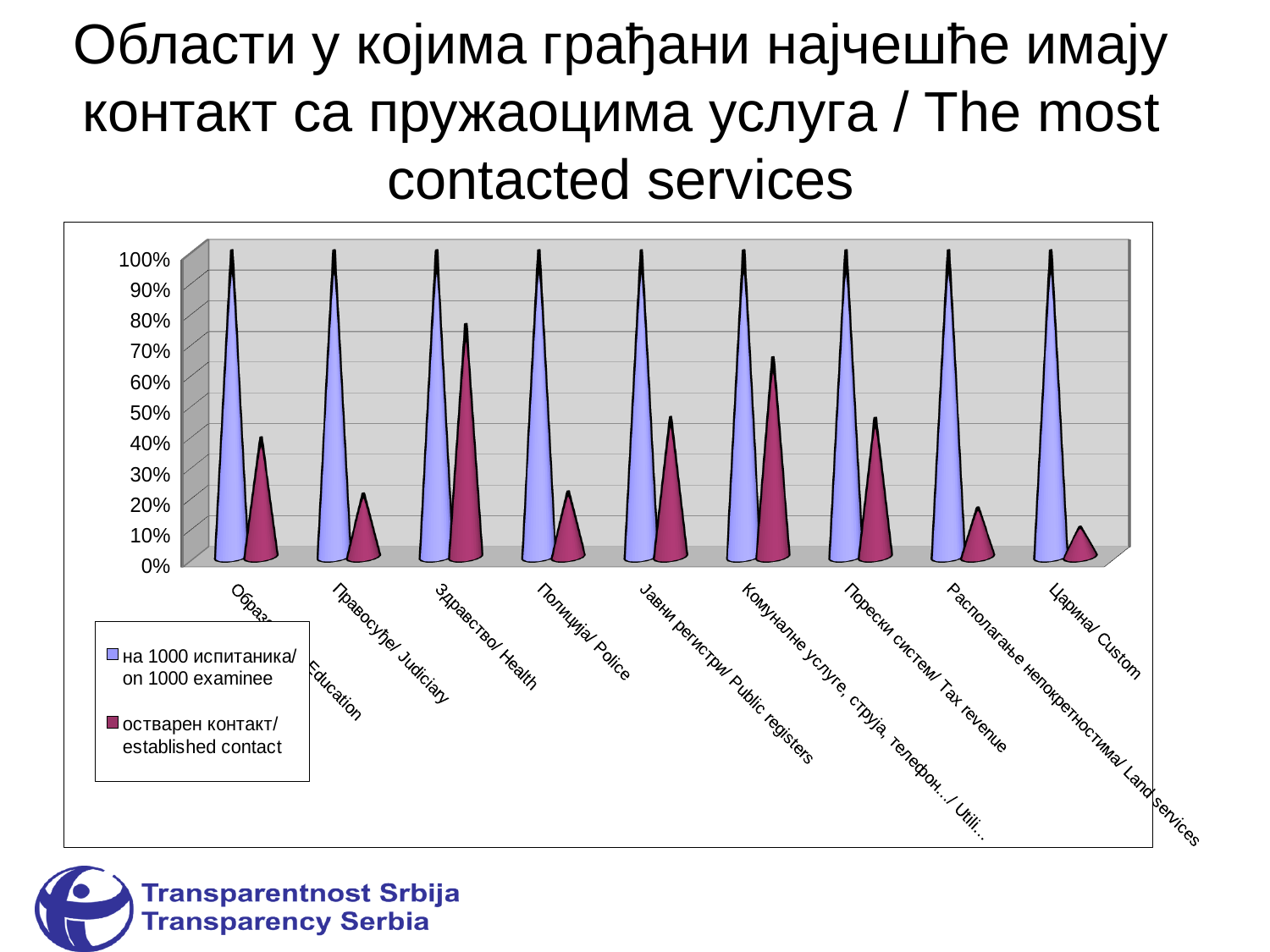
Is the 'established contact' value for Царина/ Custom greater or less than 20%? less How many service categories are plotted on the x axis? 9 Is the 'established contact' value for Комуналне услуге/ Utilities greater or less than 60%? greater Which category has the lowest value for 'остварен контакт/ established contact'? Царина/ Custom What colour are the bars for the 'остварен контакт/ established contact' series? dark red/magenta What type of chart is shown on the slide? bar chart Which has a larger 'established contact' value, Здравство/ Health or Полиција/ Police? Здравство/ Health How many series does the legend list? 2 Is the 'established contact' value for Здравство/ Health greater or less than 70%? greater Which category has the highest value for 'остварен контакт/ established contact'? Здравство/ Health What is the value of the 'на 1000 испитаника/ on 1000 examinee' series for Полиција/ Police? 100%